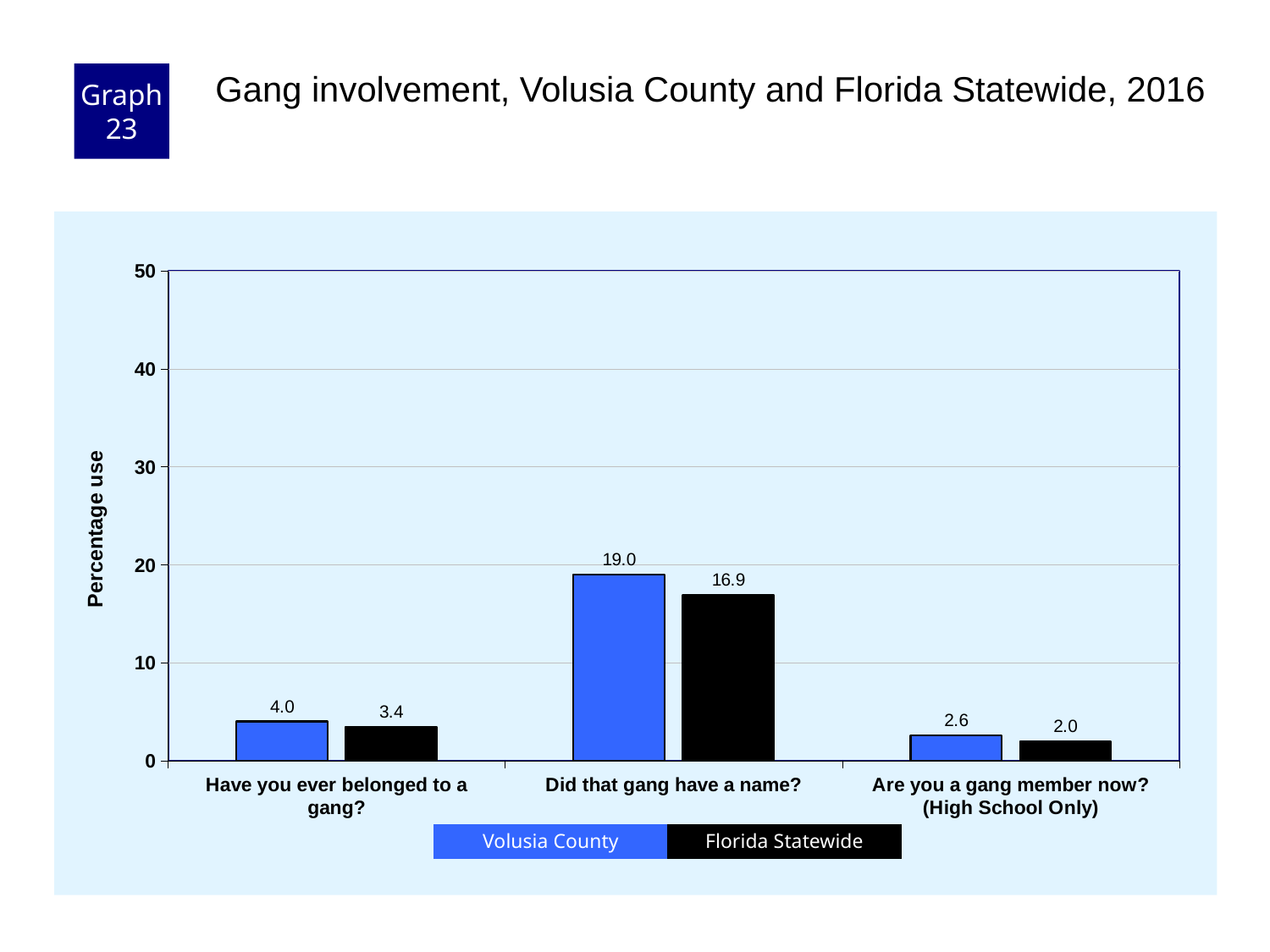
What is the difference between the Volusia County and Florida Statewide values for "Have you ever belonged to a gang?"? 0.6 What is the difference between the Volusia County and Florida Statewide values for "Did that gang have a name?"? 2.1 Is the Volusia County value for "Did that gang have a name?" greater or less than 10? greater What is the Florida Statewide value for "Have you ever belonged to a gang?"? 3.4 How many question categories are shown on the x axis? 3 For "Are you a gang member now? (High School Only)", which is larger, Volusia County or Florida Statewide? Volusia County Which question has the highest Volusia County value? Did that gang have a name? What is the Florida Statewide value for "Are you a gang member now? (High School Only)"? 2.0 Which question has the lowest Florida Statewide value? Are you a gang member now? (High School Only) What kind of chart is shown on the slide? Bar chart How many series does the legend list? 2 What is the Volusia County value for "Did that gang have a name?"? 19.0